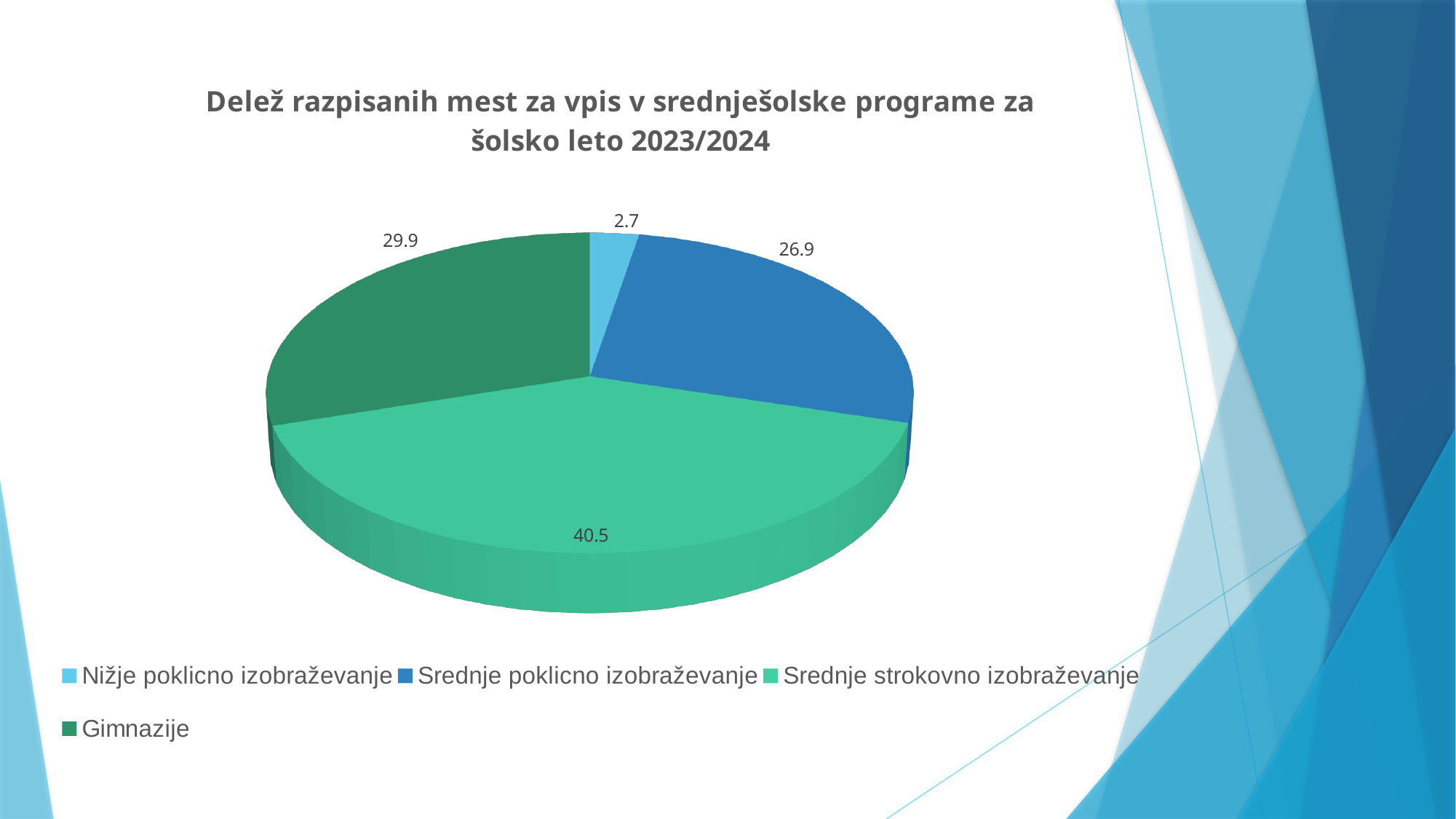
How many categories does the pie chart have? 4 What is the value for Nižje poklicno izobraževanje? 2.7 Which category has the smallest slice of the pie? Nižje poklicno izobraževanje What is the difference between the values for Srednje strokovno izobraževanje and Gimnazije? 10.6 What is the value for Srednje strokovno izobraževanje? 40.5 What kind of chart is shown on the slide? pie chart What is the difference between the values for Srednje poklicno izobraževanje and Nižje poklicno izobraževanje? 24.2 Which category has the largest slice of the pie? Srednje strokovno izobraževanje What is the title of the chart? Delež razpisanih mest za vpis v srednješolske programe za šolsko leto 2023/2024 What is the value for Srednje poklicno izobraževanje? 26.9 What is the value for Gimnazije? 29.9 Which is larger, the value for Gimnazije or the value for Srednje poklicno izobraževanje? Gimnazije